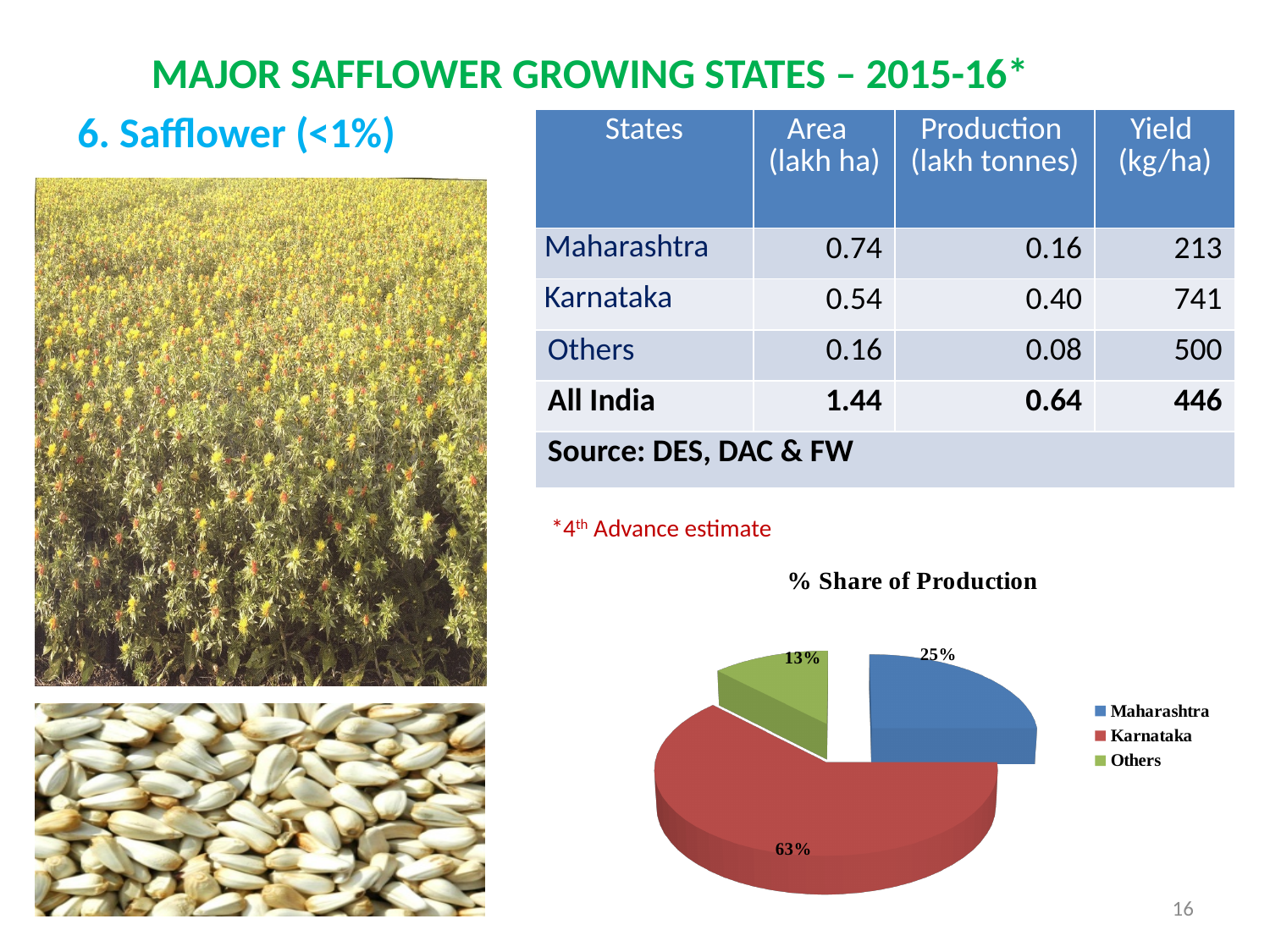
Which has a larger share in the pie chart, Maharashtra or Others? Maharashtra What type of chart is shown on the slide? pie chart What share of production does Others have in the pie chart? 13% How many slices does the pie chart have? 3 Which category has the largest slice in the pie chart? Karnataka What is the title of the chart? % Share of Production How many entries does the legend of the pie chart list? 3 What is the difference in percentage points between Karnataka's and Maharashtra's shares in the pie chart? 38 Which category has the smallest slice in the pie chart? Others What share of production does Maharashtra have in the pie chart? 25% Which colour represents Karnataka in the pie chart? red What share of production does Karnataka have in the pie chart? 63%